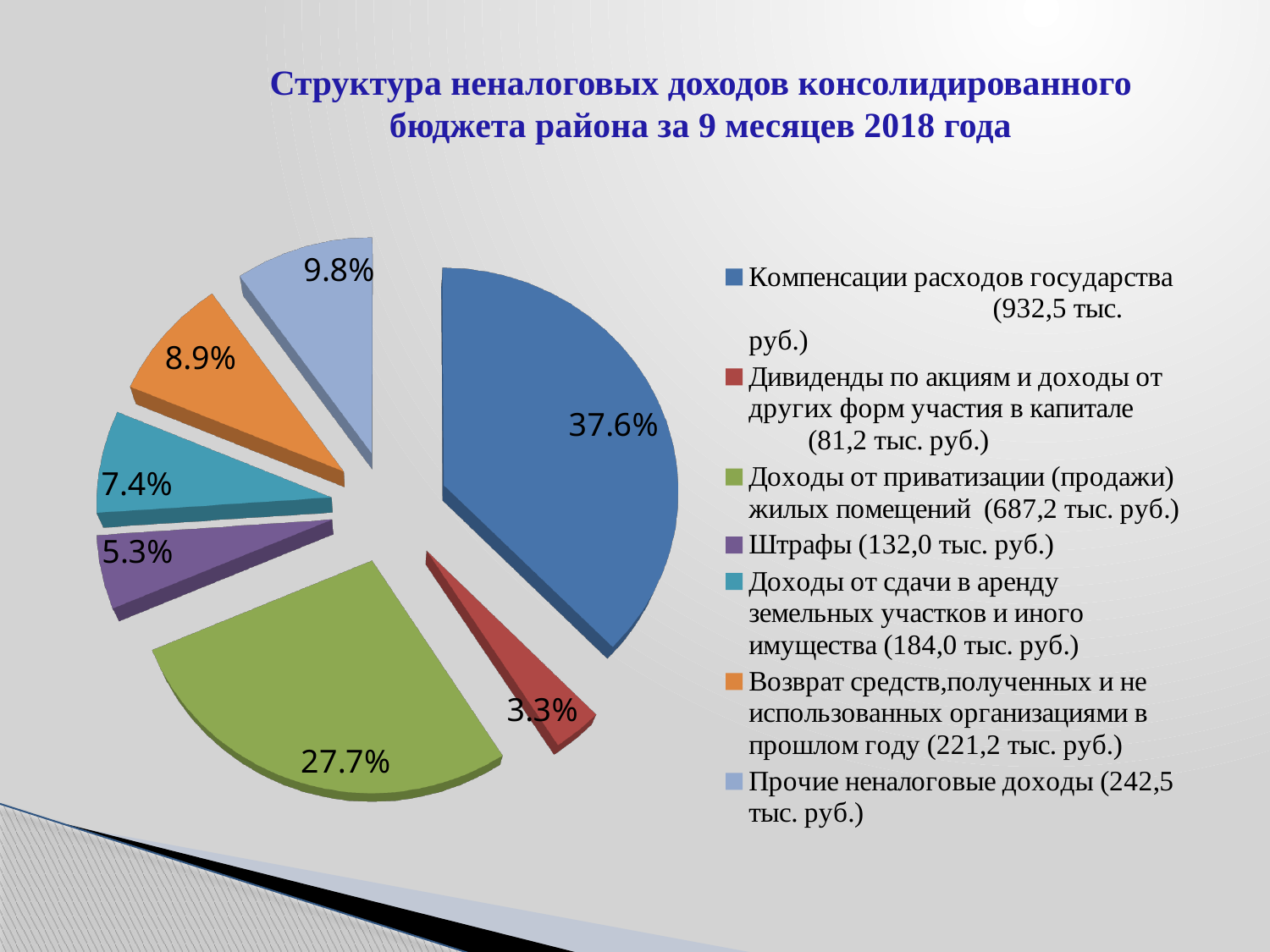
What amount in thousand rubles does the legend give for "Штрафы"? 132,0 тыс. руб. What share of the pie does "Штрафы" have? 5.3% What kind of chart is shown on the slide? Pie chart Which category has the largest slice of the pie? Компенсации расходов государства How many slices does the pie chart have? 7 What share of the pie does "Дивиденды по акциям и доходы от других форм участия в капитале" have? 3.3% Which category has the smallest slice of the pie? Дивиденды по акциям и доходы от других форм участия в капитале Which slice is larger: "Возврат средств, полученных и не использованных организациями в прошлом году" or "Доходы от сдачи в аренду земельных участков и иного имущества"? Возврат средств, полученных и не использованных организациями в прошлом году What is the difference in percentage points between the slices for "Компенсации расходов государства" and "Доходы от приватизации (продажи) жилых помещений"? 9.9 What share of the pie does "Доходы от приватизации (продажи) жилых помещений" have? 27.7%